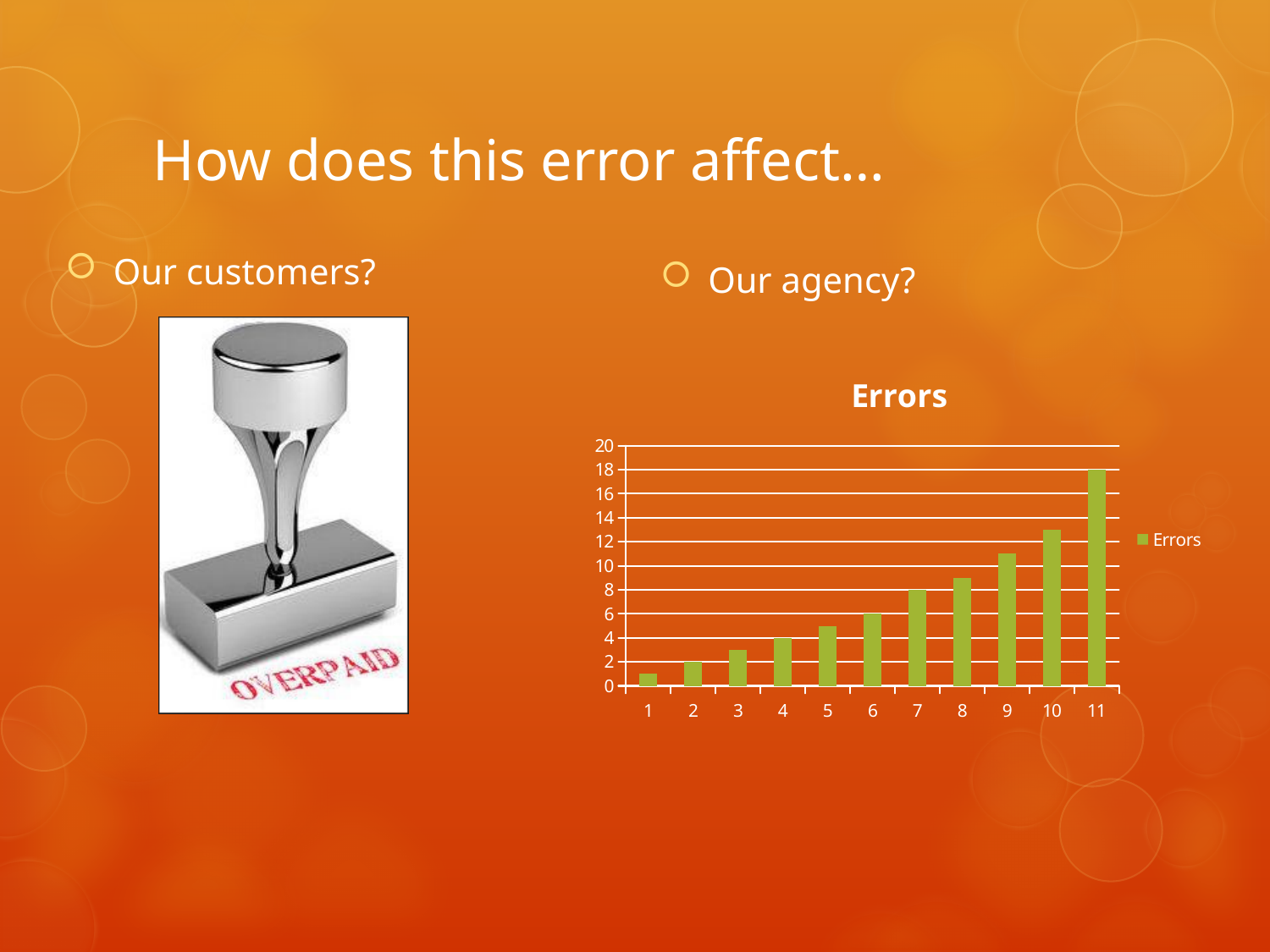
Which category has the highest value in the Errors chart? 11 How many series does the legend of the Errors chart list? 1 What type of chart is shown on the slide? bar chart Is the value for category 10 greater or less than 12? greater What is the title of the chart? Errors Which has a larger value in the Errors chart, category 3 or category 10? 10 How many categories are shown on the x axis of the Errors chart? 11 Is the value for category 1 greater or less than 2? less What is the value for category 11 in the Errors chart? 18 What is the value for category 6 in the Errors chart? 6 Which category has the lowest value in the Errors chart? 1 Do the values in the Errors chart rise or fall from category 1 to category 11? rise